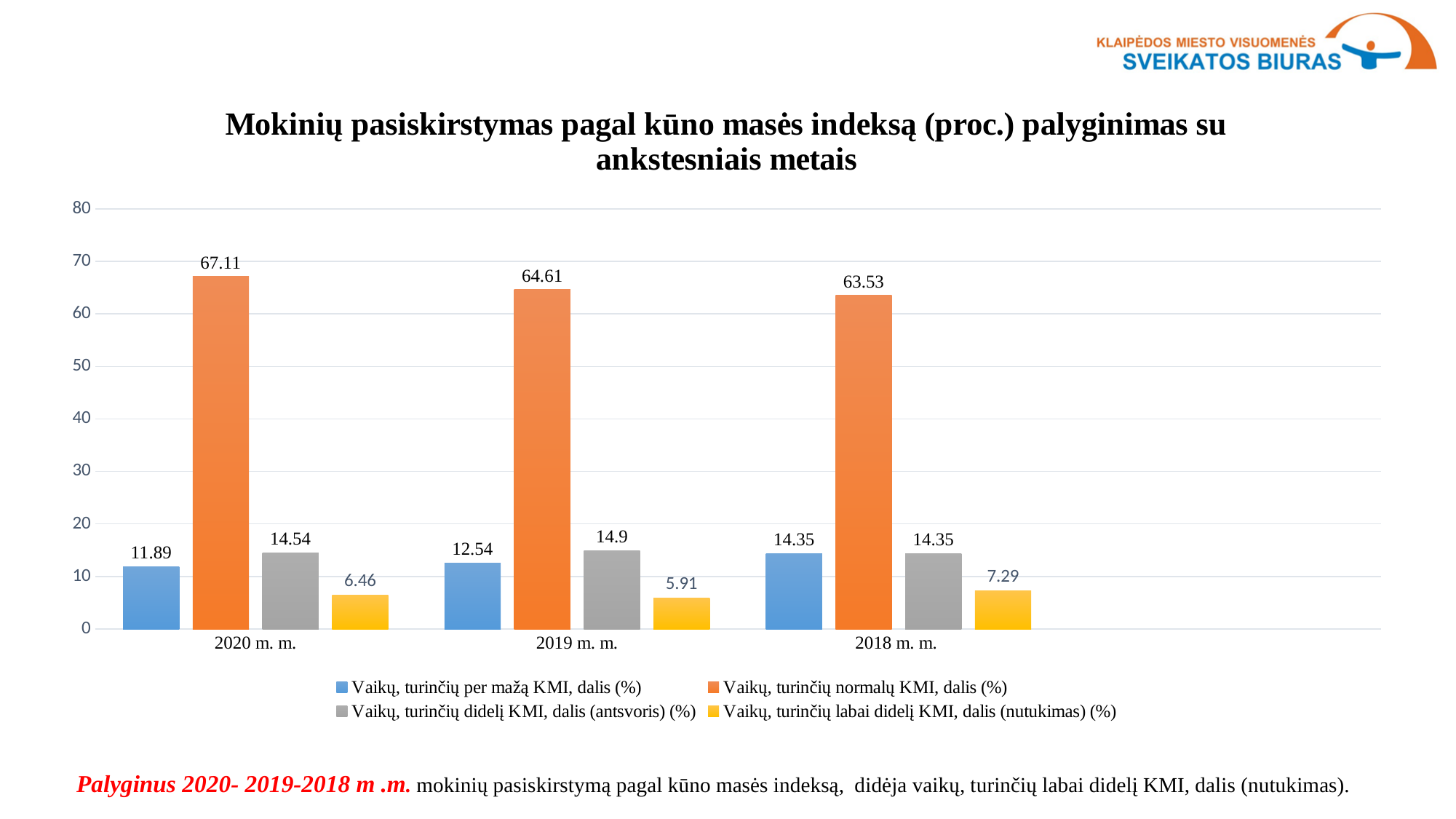
What is the value for 'Vaikų, turinčių per mažą KMI, dalis (%)' in 2019 m. m.? 12.54 What is the value for 'Vaikų, turinčių normalų KMI, dalis (%)' in 2020 m. m.? 67.11 What kind of chart is shown on the slide? bar chart Is the value for 'Vaikų, turinčių normalų KMI, dalis (%)' in 2018 m. m. greater or less than 60? greater What is the value for 'Vaikų, turinčių labai didelį KMI, dalis (nutukimas) (%)' in 2018 m. m.? 7.29 In which school year is the value for 'Vaikų, turinčių labai didelį KMI, dalis (nutukimas) (%)' lowest? 2019 m. m. How many series does the legend list? 4 How many school years (categories) are shown on the x axis? 3 What is the difference between the 'Vaikų, turinčių labai didelį KMI, dalis (nutukimas) (%)' values for 2018 m. m. and 2019 m. m.? 1.38 Which is larger: 'Vaikų, turinčių per mažą KMI, dalis (%)' in 2020 m. m. or in 2018 m. m.? 2018 m. m. What is the difference between the 'Vaikų, turinčių normalų KMI, dalis (%)' values for 2020 m. m. and 2019 m. m.? 2.5 In which school year is the value for 'Vaikų, turinčių normalų KMI, dalis (%)' highest? 2020 m. m.